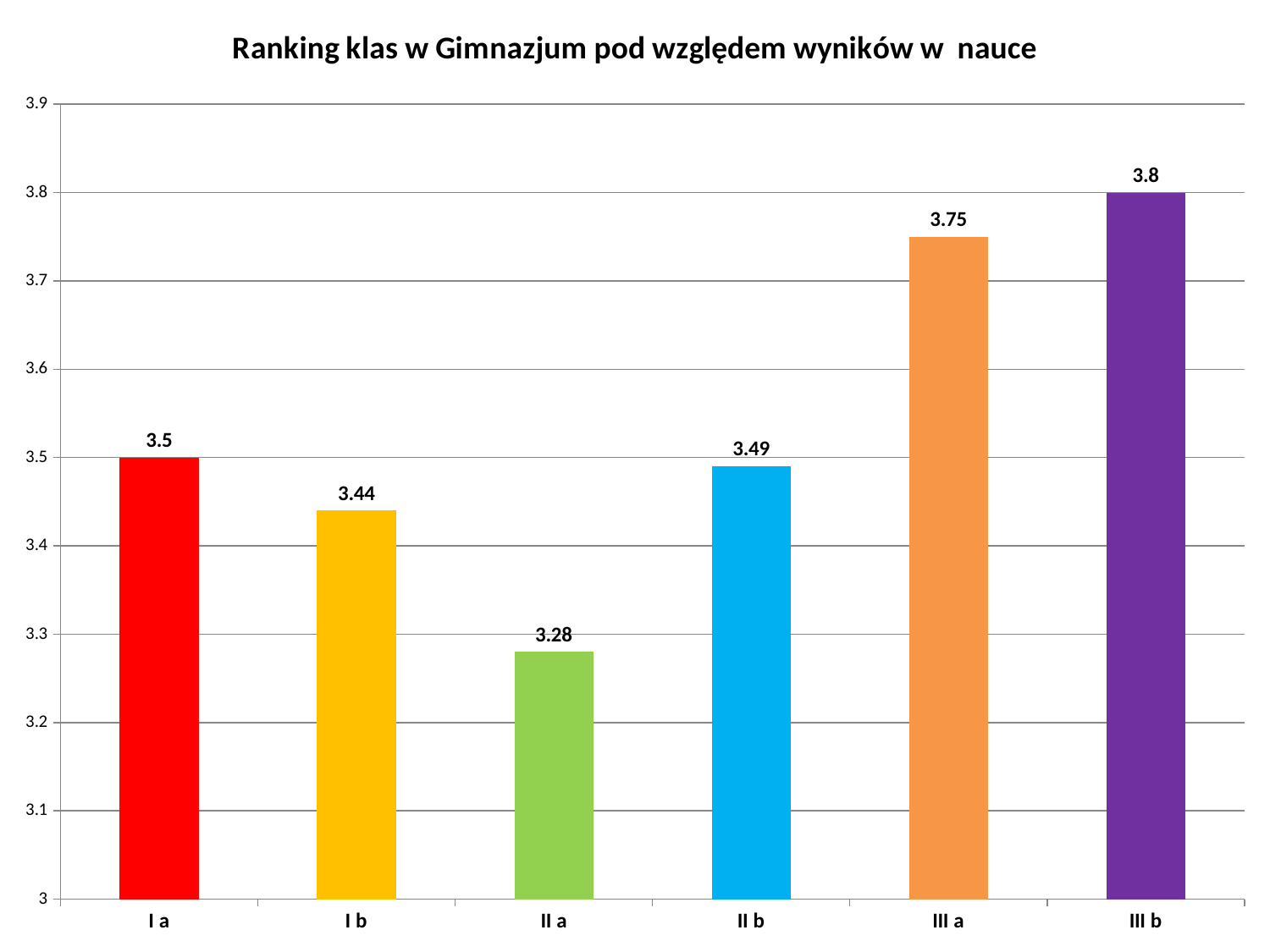
What is the value for class III a? 3.75 What is the value for class II a? 3.28 What is the difference between the values for I a and I b? 0.06 What is the value for class I a? 3.5 Which class has the highest value? III b What is the title of the chart? Ranking klas w Gimnazjum pod względem wyników w nauce Which class has the lowest value? II a What is the difference between the values for III b and II a? 0.52 How many classes are shown on the chart? 6 Which is larger, the value for I b or the value for III a? III a What kind of chart is this? bar chart Is the value for II b greater or less than 3.6? less